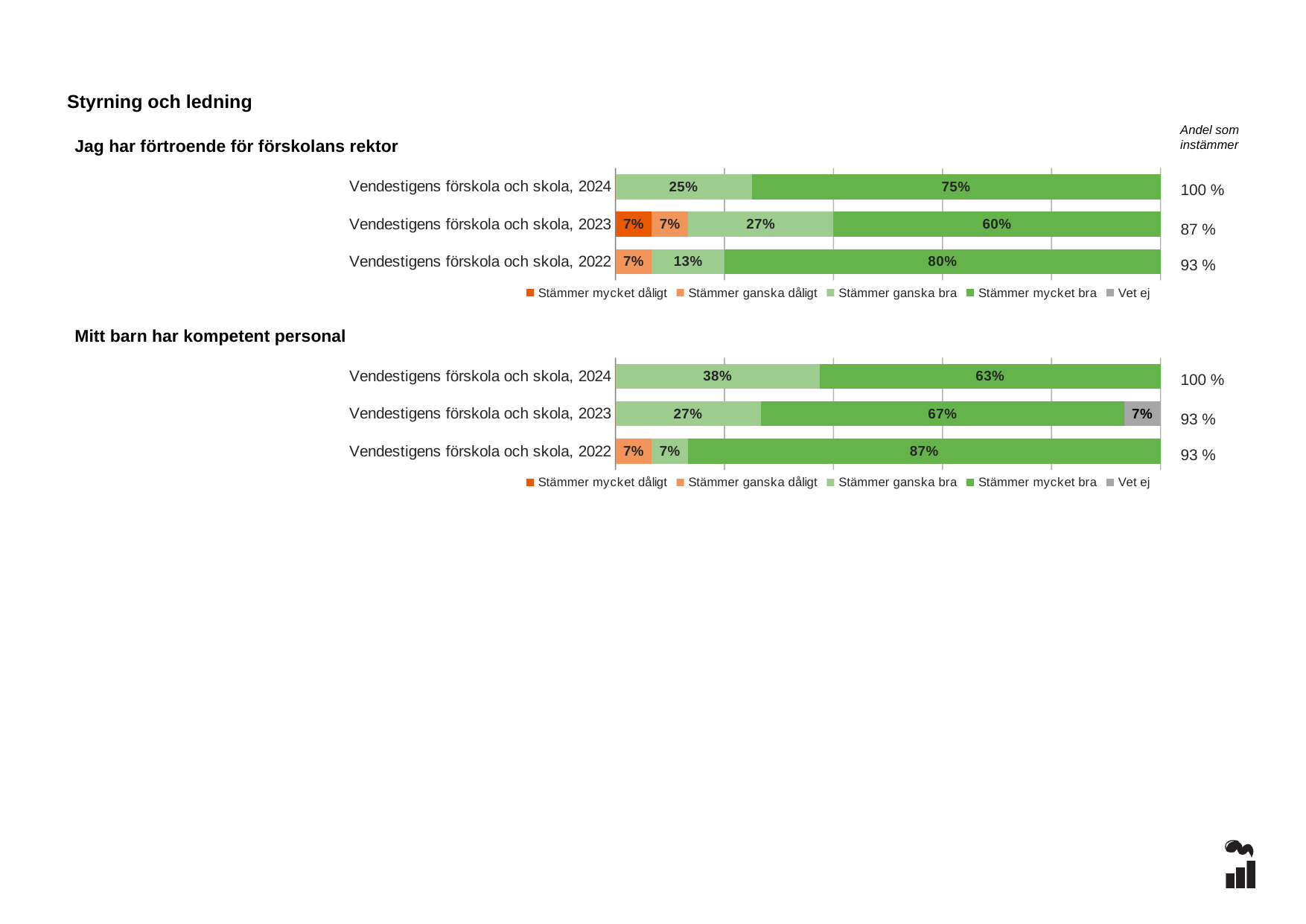
In the chart 'Mitt barn har kompetent personal', is the 'Stämmer mycket bra' value larger for 2022 or 2023? 2022 In the chart 'Jag har förtroende för förskolans rektor', which year has the highest value for 'Stämmer mycket bra'? Vendestigens förskola och skola, 2022 How many series does the legend of the chart 'Mitt barn har kompetent personal' list? 5 In the chart 'Jag har förtroende för förskolans rektor', what is the value for 'Stämmer mycket dåligt' for Vendestigens förskola och skola, 2023? 7% What kind of chart is 'Jag har förtroende för förskolans rektor'? Stacked bar chart In the chart 'Mitt barn har kompetent personal', what is the value for 'Stämmer ganska bra' for Vendestigens förskola och skola, 2024? 38% In the chart 'Jag har förtroende för förskolans rektor', what is the difference between the 'Stämmer mycket bra' values for 2022 and 2023? 20% In the chart 'Mitt barn har kompetent personal', which year has the lowest value for 'Stämmer mycket bra'? Vendestigens förskola och skola, 2024 In the chart 'Jag har förtroende för förskolans rektor', what is the value for 'Stämmer ganska bra' for Vendestigens förskola och skola, 2023? 27% How many bars are shown in the chart 'Jag har förtroende för förskolans rektor'? 3 In the chart 'Mitt barn har kompetent personal', what is the value for 'Vet ej' for Vendestigens förskola och skola, 2023? 7% In the chart 'Jag har förtroende för förskolans rektor', what is the value for 'Stämmer mycket bra' for Vendestigens förskola och skola, 2024? 75%